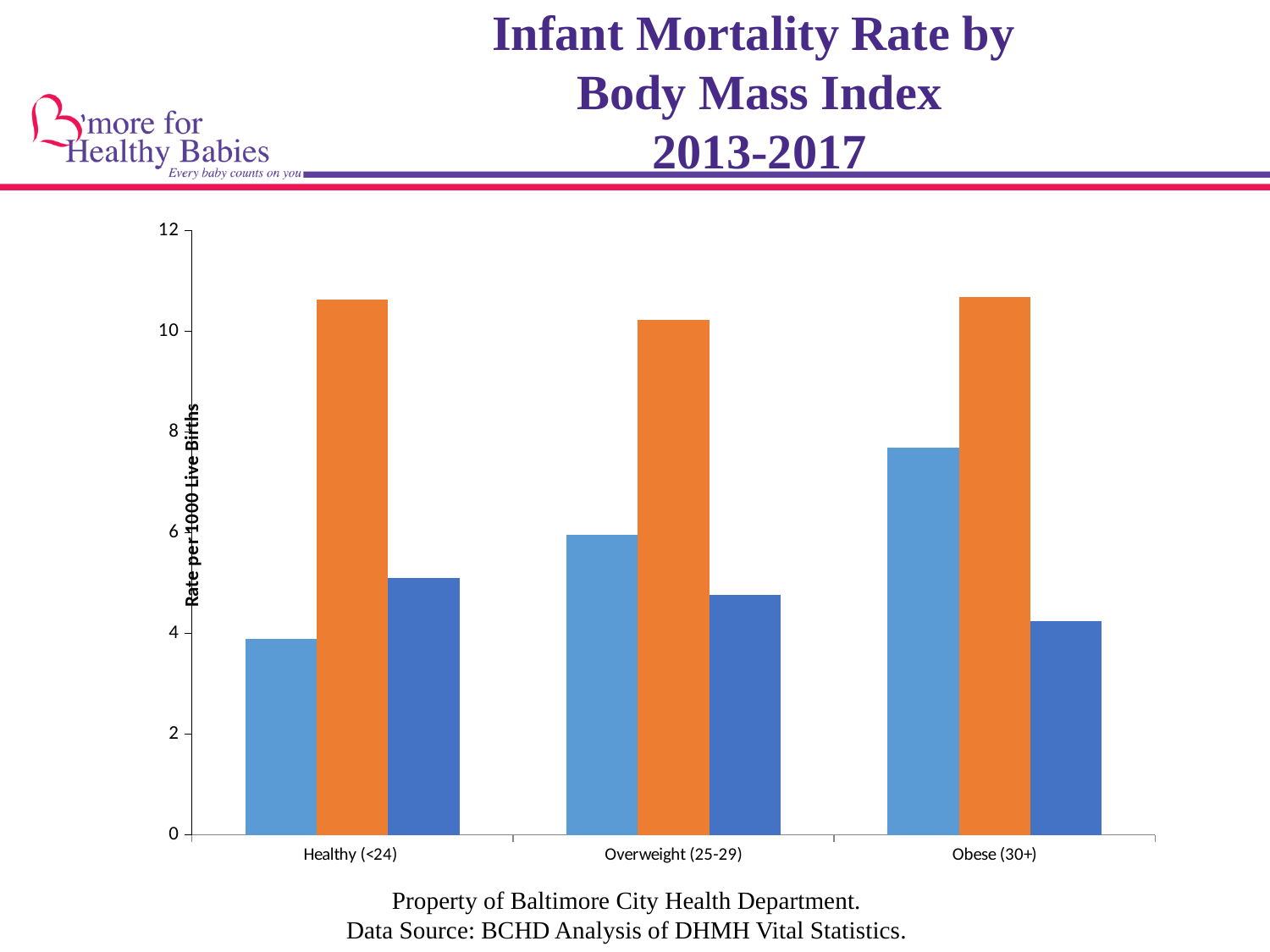
Among the dark blue bars, which BMI category has the lowest value? Obese (30+) What kind of chart is shown on the slide? bar chart Is the value of the orange bar for Overweight (25-29) greater or less than 8? greater How many BMI categories are shown on the x axis? 3 Is the value of the light blue bar for Obese (30+) greater or less than 6? greater Among the light blue bars, which BMI category has the highest value? Obese (30+) Which is larger: the light blue bar for Healthy (<24) or the light blue bar for Obese (30+)? Obese (30+) Do the dark blue bars rise or fall from Healthy (<24) to Obese (30+)? fall What is the label on the y axis of the chart? Rate per 1000 Live Births Is the value of the dark blue bar for Healthy (<24) greater or less than 4? greater Do the light blue bars rise or fall from Healthy (<24) to Obese (30+)? rise